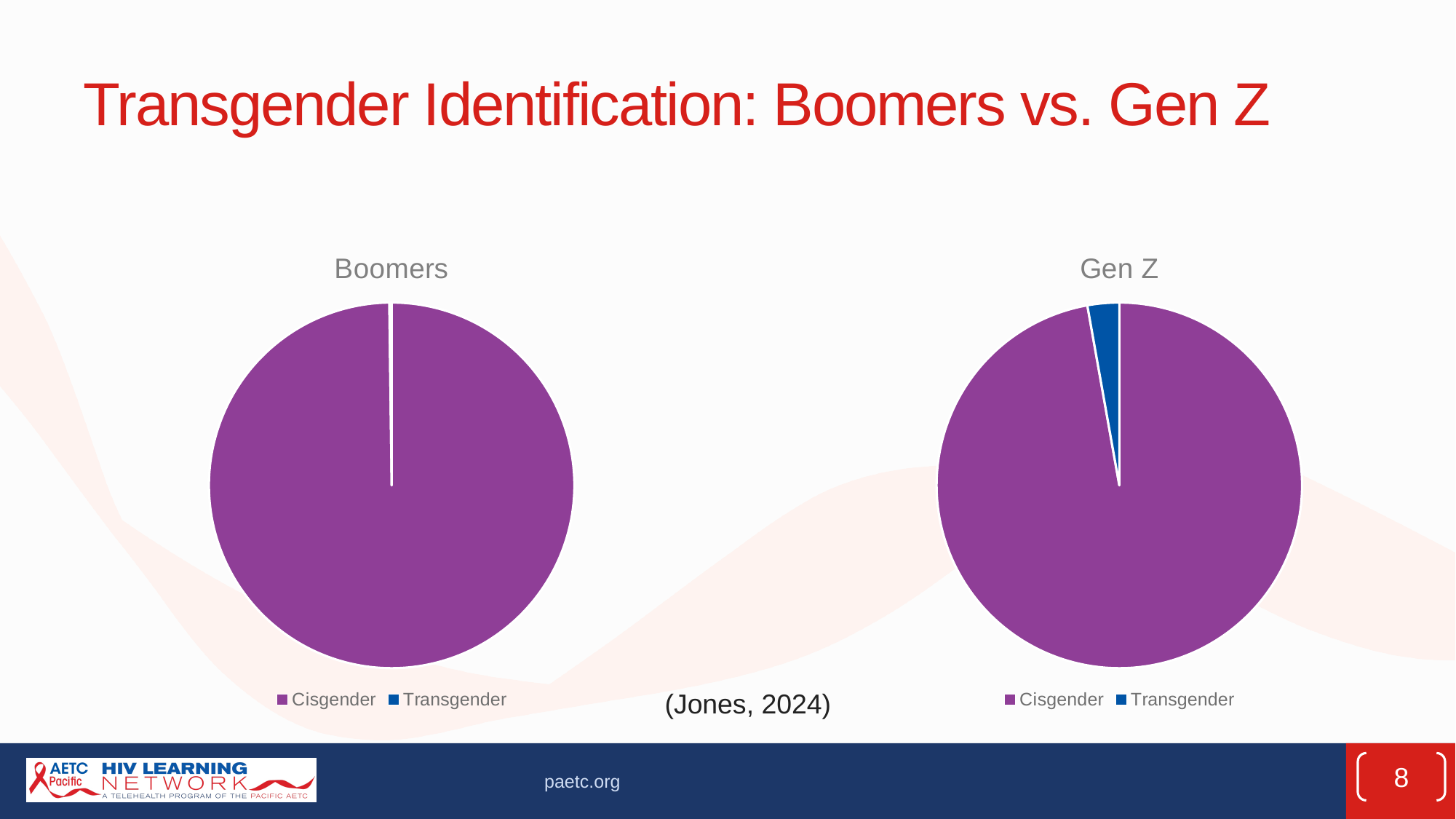
In the Gen Z chart, which category has the largest slice? Cisgender How many categories does the legend of the Gen Z chart list? 2 What kind of chart is the Gen Z chart? Pie chart Which chart, Boomers or Gen Z, shows a larger Transgender slice? Gen Z What kind of chart is the Boomers chart? Pie chart In the Gen Z chart, which slice is larger, Cisgender or Transgender? Cisgender In the Boomers chart, which category has the largest slice? Cisgender How many categories does the legend of the Boomers chart list? 2 In the Boomers chart, which category has the smallest slice? Transgender What colour represents Transgender in the Gen Z chart? Blue In the Gen Z chart, which category has the smallest slice? Transgender What is the title of the chart on the left of the slide? Boomers